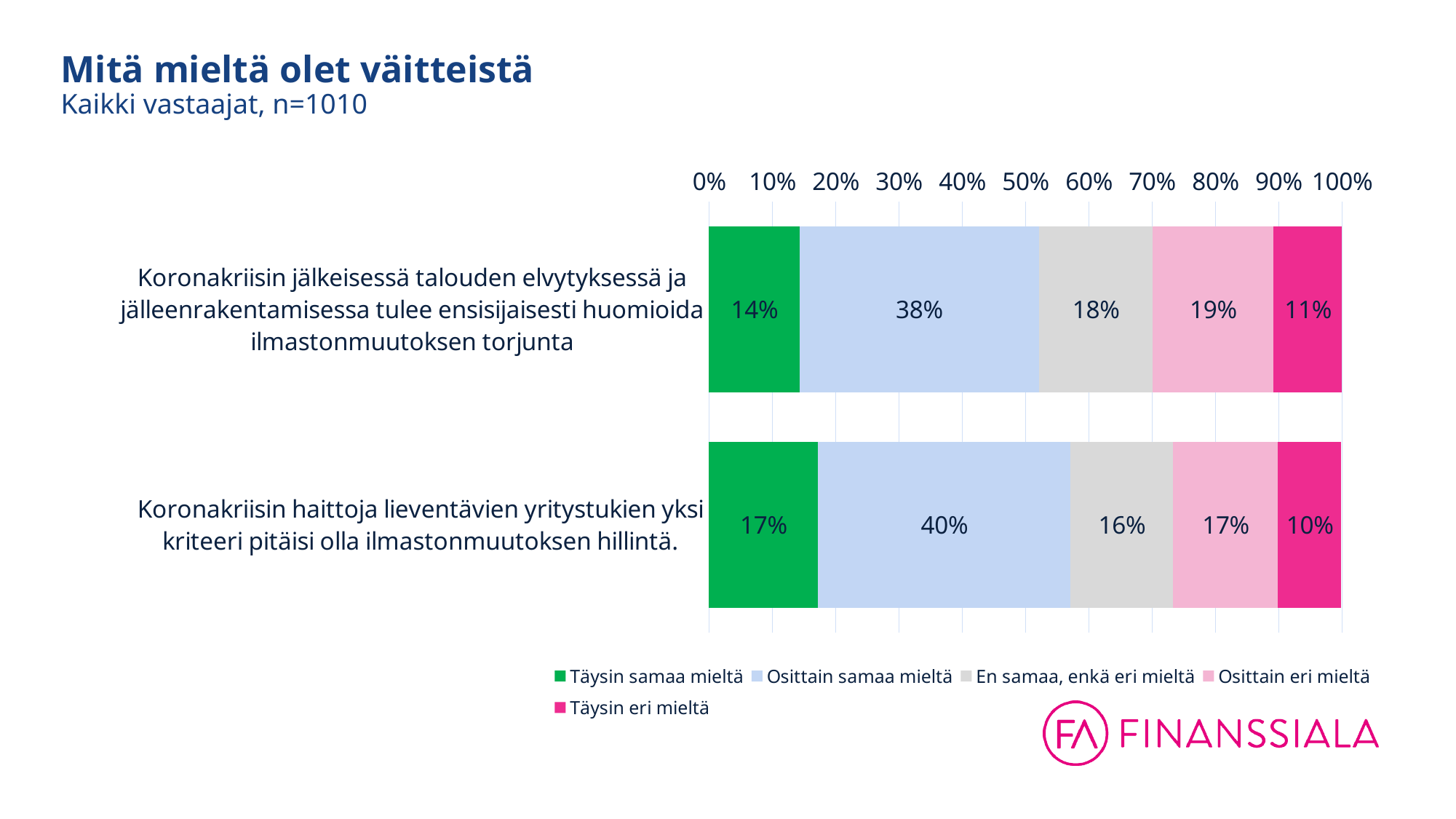
What type of chart is shown on the slide? Stacked bar chart How many statements (bars) are shown in the chart? 2 What percentage of respondents answered "Täysin samaa mieltä" to the statement "Koronakriisin jälkeisessä talouden elvytyksessä ja jälleenrakentamisessa tulee ensisijaisesti huomioida ilmastonmuutoksen torjunta"? 14% What is the total of the stacked bar for the statement about yritystuet? 100% What is the difference in the "Täysin samaa mieltä" share between the yritystuet statement and the talouden elvytys statement? 3 percentage points Which response option has the smallest share for the statement about yritystuet? Täysin eri mieltä Which statement has a larger "En samaa, enkä eri mieltä" share? Koronakriisin jälkeisessä talouden elvytyksessä ja jälleenrakentamisessa tulee ensisijaisesti huomioida ilmastonmuutoksen torjunta How many response options does the legend list? 5 Which response option has the largest share for the statement about talouden elvytys? Osittain samaa mieltä What is the "Täysin eri mieltä" share for the statement about yritystuet (business subsidies)? 10% What percentage of respondents answered "Osittain samaa mieltä" to the statement "Koronakriisin haittoja lieventävien yritystukien yksi kriteeri pitäisi olla ilmastonmuutoksen hillintä"? 40% What is the "Osittain eri mieltä" share for the statement about talouden elvytys (economic recovery)? 19%